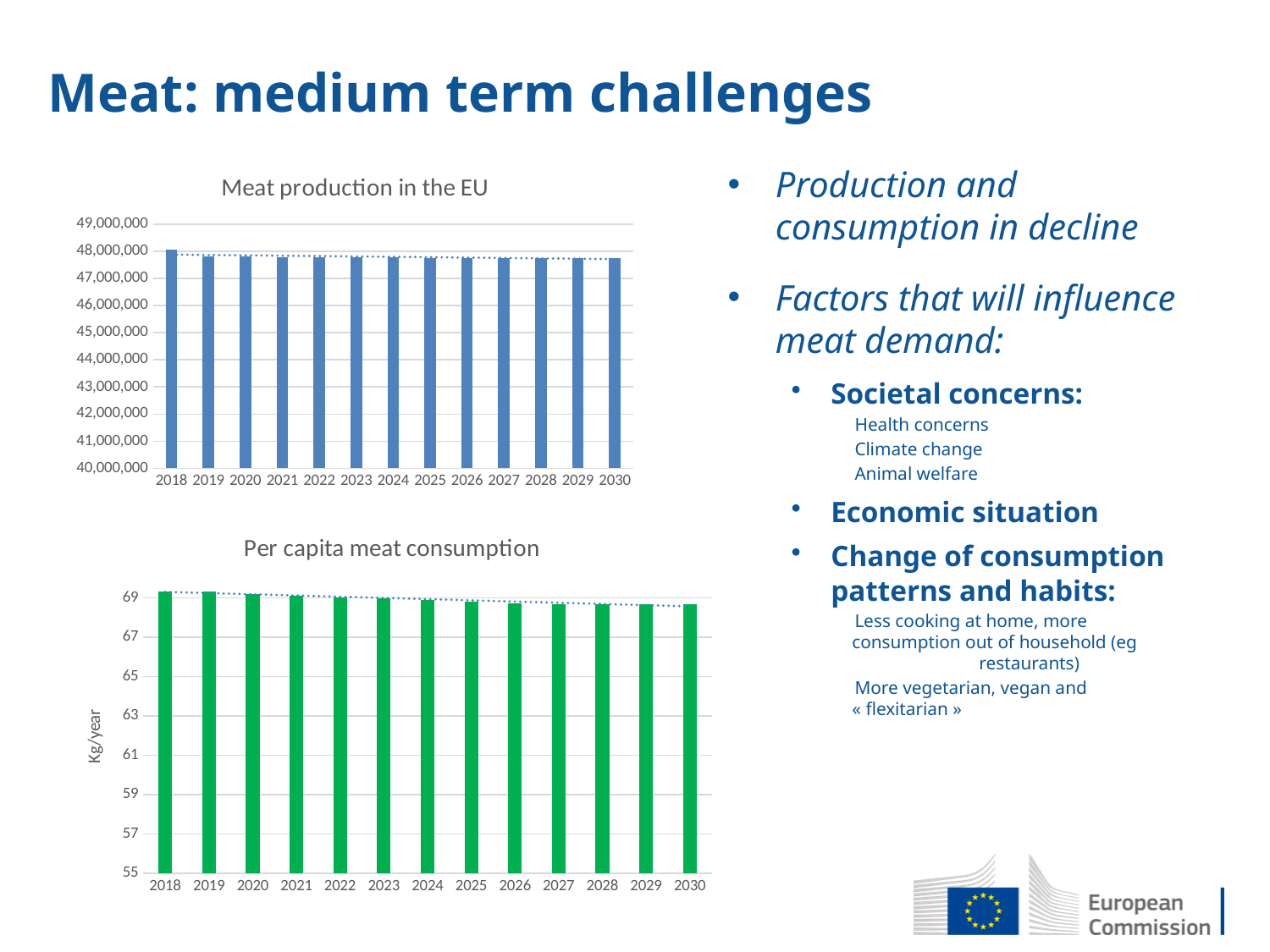
In the 'Meat production in the EU' chart, is the value for 2018 greater or less than 47,000,000? greater How many years are shown on the x axis of the 'Per capita meat consumption' chart? 13 What is the y-axis label on the 'Per capita meat consumption' chart? Kg/year In the 'Meat production in the EU' chart, do the values rise or fall from 2018 to 2030? fall How many years are shown on the x axis of the 'Meat production in the EU' chart? 13 What kind of chart is the 'Meat production in the EU' chart? bar chart In the 'Meat production in the EU' chart, which is larger, the value for 2018 or the value for 2030? 2018 What kind of chart is the 'Per capita meat consumption' chart? bar chart In the 'Per capita meat consumption' chart, do the values rise or fall from 2018 to 2030? fall In the 'Meat production in the EU' chart, is the value for 2030 greater or less than 48,000,000? less In the 'Per capita meat consumption' chart, is the value for 2030 greater or less than 67? greater In the 'Meat production in the EU' chart, which year has the highest value? 2018